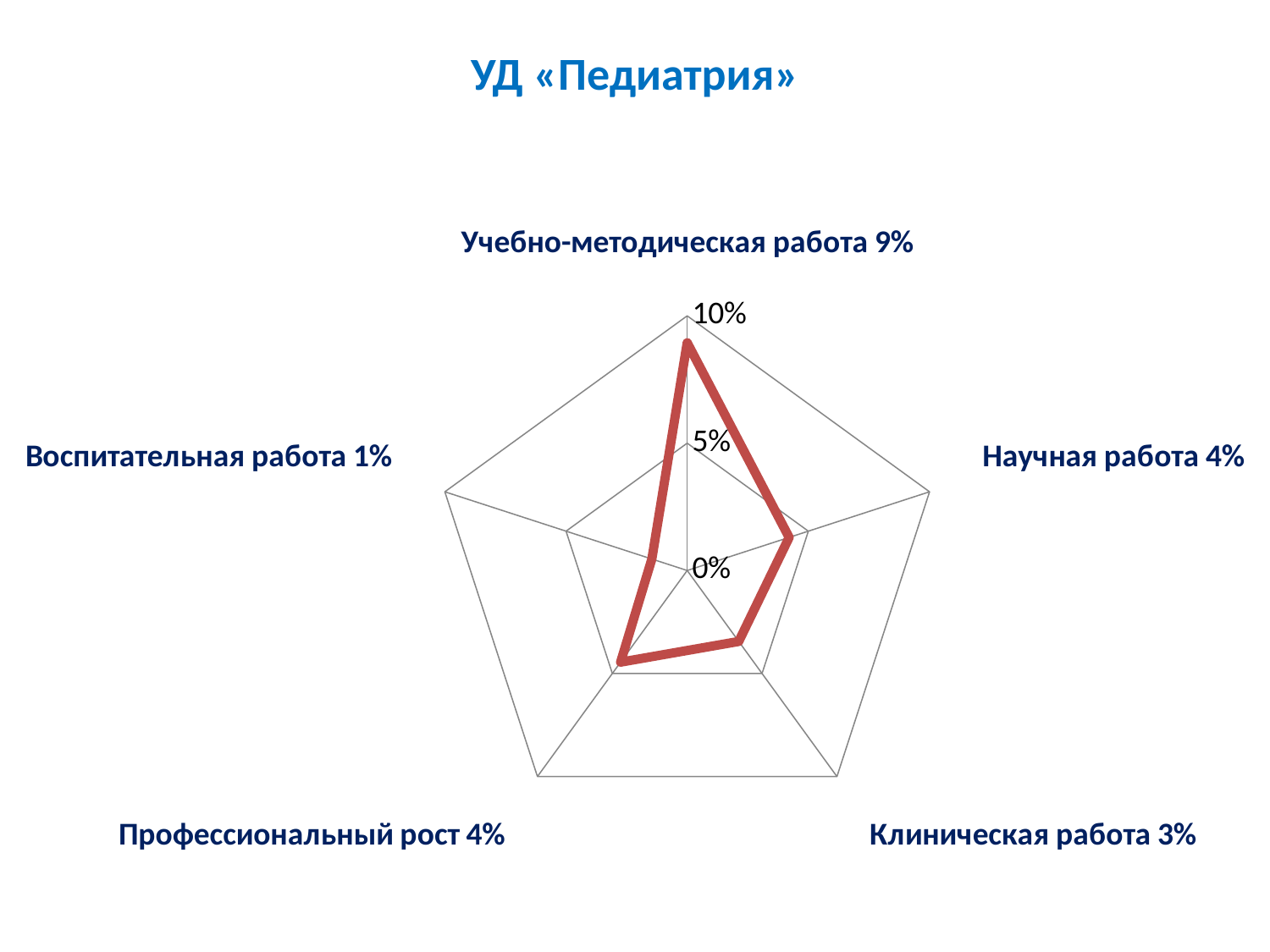
Which is larger, the value for Клиническая работа or the value for Профессиональный рост? Профессиональный рост What is the value for Воспитательная работа? 1% What is the difference between the values for Учебно-методическая работа and Научная работа? 5% What is the value for Учебно-методическая работа? 9% Which category has the highest value? Учебно-методическая работа What is the title of the slide? УД «Педиатрия» What is the value for Научная работа? 4% What kind of chart is shown on the slide? Radar chart Which category has the lowest value? Воспитательная работа Is the value for Учебно-методическая работа greater or less than 5%? greater What is the value for Клиническая работа? 3% How many categories (axes) does the radar chart have? 5